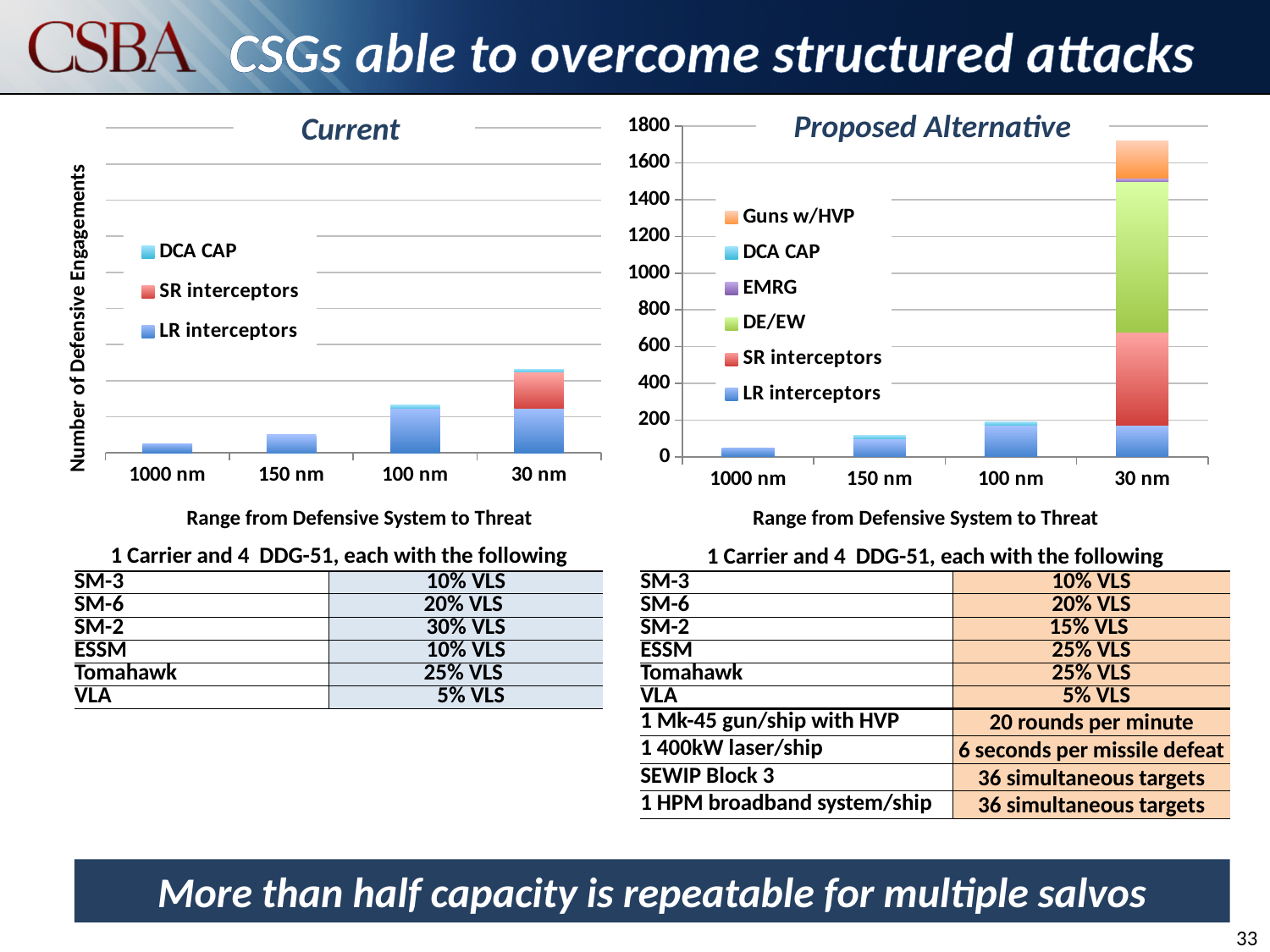
In the "Proposed Alternative" chart, is the total for 1000 nm greater or less than 200? less How many series does the legend of the "Proposed Alternative" chart list? 6 What kind of chart is the "Current" chart on the left? Stacked bar chart How many range categories are shown on the x axis of the "Proposed Alternative" chart? 4 In the "Proposed Alternative" chart, is the total for 150 nm greater or less than 200? less In the "Proposed Alternative" chart, which bar is taller: 100 nm or 30 nm? 30 nm In the "Current" chart, do the bar totals rise or fall moving from 1000 nm to 30 nm along the x axis? Rise In the "Current" chart, which range category has the shortest bar? 1000 nm What is the y-axis label of the "Current" chart? Number of Defensive Engagements How many series does the legend of the "Current" chart list? 3 In the "Proposed Alternative" chart, which range category has the tallest bar? 30 nm In the "Proposed Alternative" chart, is the total for 30 nm greater or less than 1600? greater